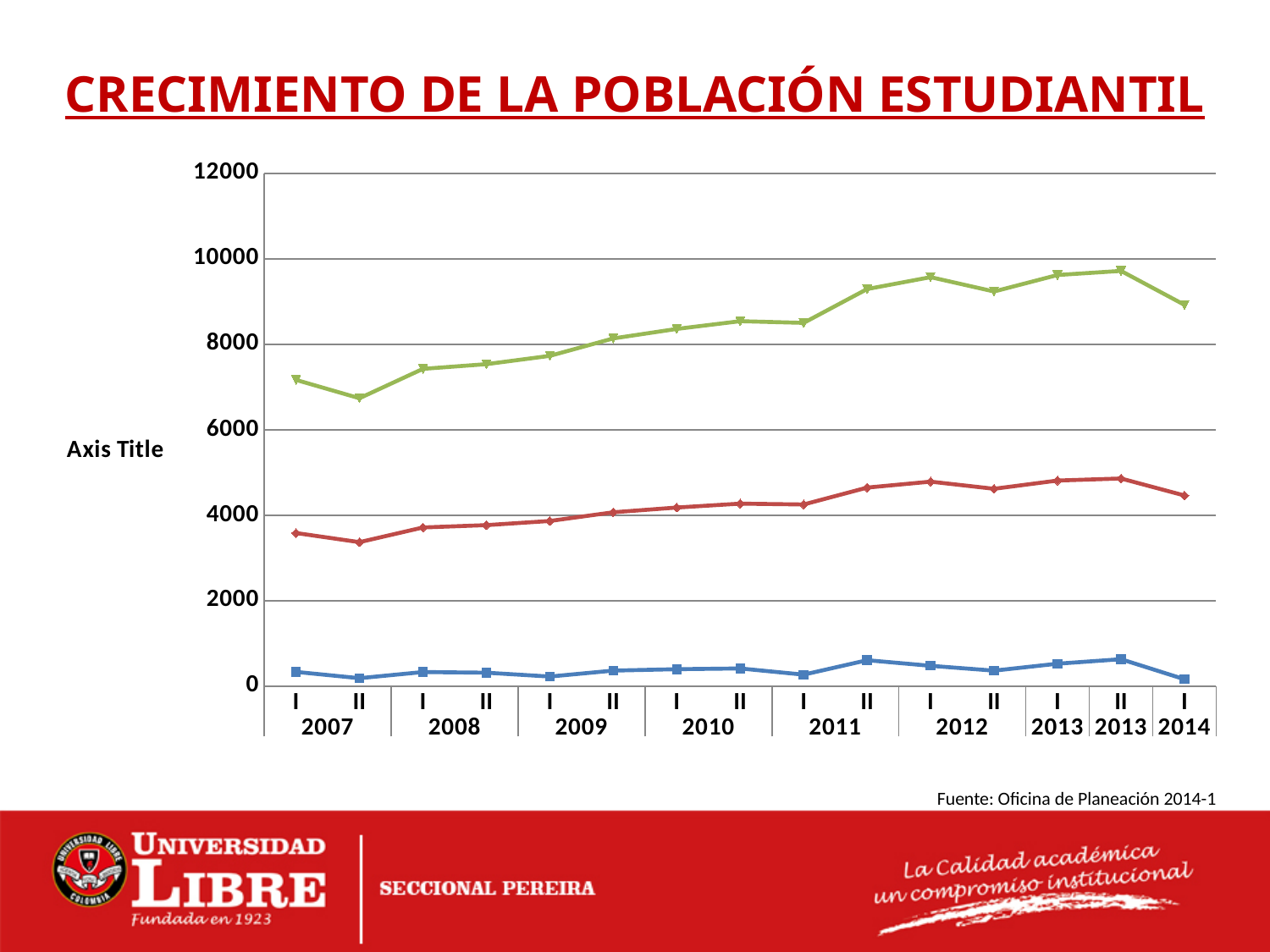
At I 2012, which line has the higher value, the green line or the red line? green line Is the value of the red line at II 2007 greater or less than 4000? less Is the value of the red line at I 2014 greater or less than 4000? greater Is the value of the blue line at II 2011 greater or less than 2000? less How many lines are plotted on the chart? 3 What kind of chart is shown on the slide? line chart How many data points does each line have along the x axis? 15 Does the green line generally rise or fall from 2007 to 2013? rise At which period does the green line reach its lowest value? II 2007 What is the title of the chart on the slide? CRECIMIENTO DE LA POBLACIÓN ESTUDIANTIL